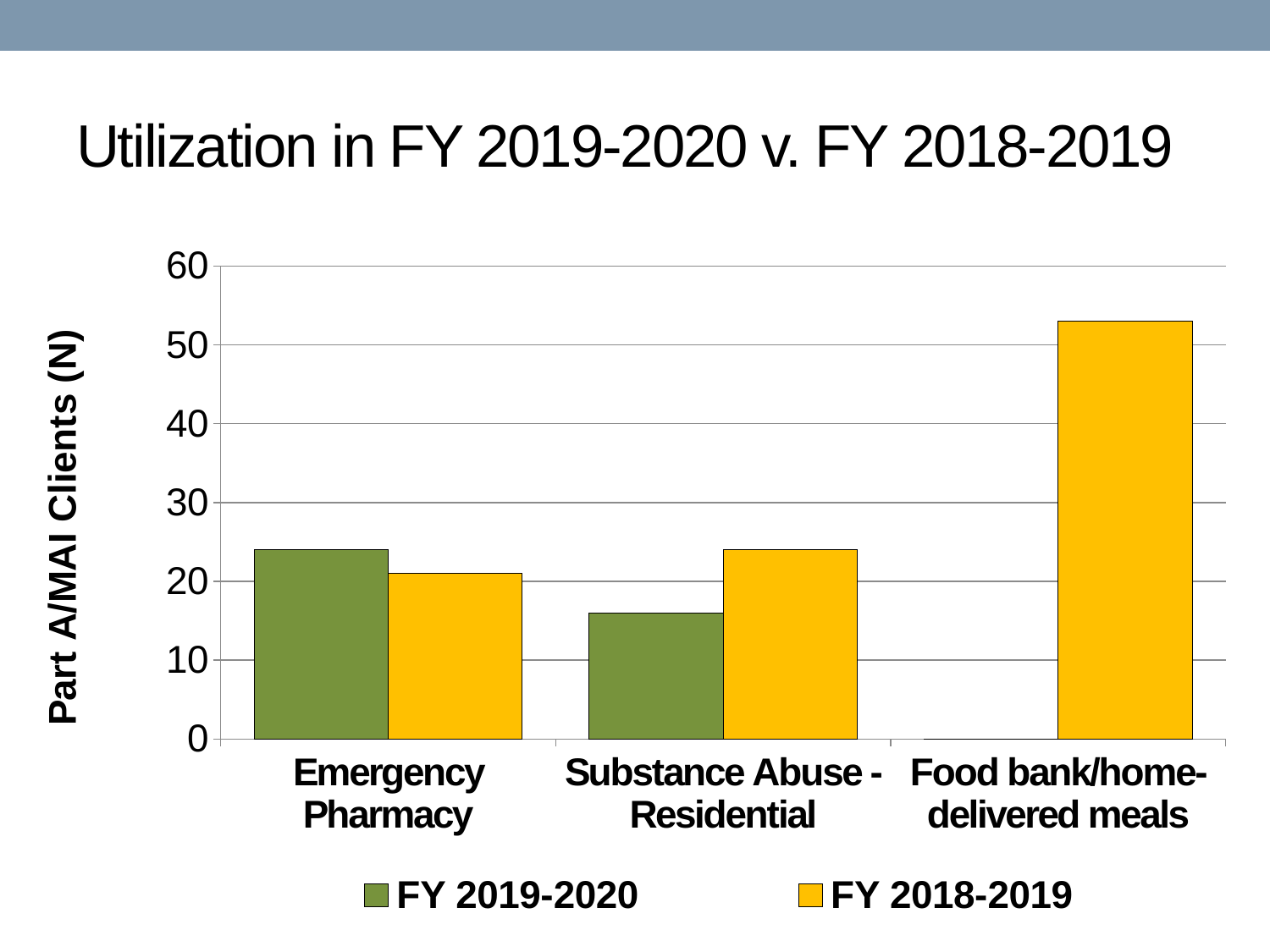
Is the FY 2018-2019 value for Food bank/home-delivered meals greater or less than 50? greater What kind of chart is shown on the slide? bar chart What is the label of the y axis? Part A/MAI Clients (N) Is the FY 2019-2020 value for Substance Abuse - Residential greater or less than 20? less How many series does the legend list? 2 Is the FY 2018-2019 value for Substance Abuse - Residential greater or less than 30? less For Substance Abuse - Residential, which series has the larger value, FY 2019-2020 or FY 2018-2019? FY 2018-2019 How many categories are shown on the x axis? 3 Which category has the highest FY 2018-2019 value? Food bank/home-delivered meals Which category has the lowest FY 2019-2020 value? Food bank/home-delivered meals For Emergency Pharmacy, which series has the larger value, FY 2019-2020 or FY 2018-2019? FY 2019-2020